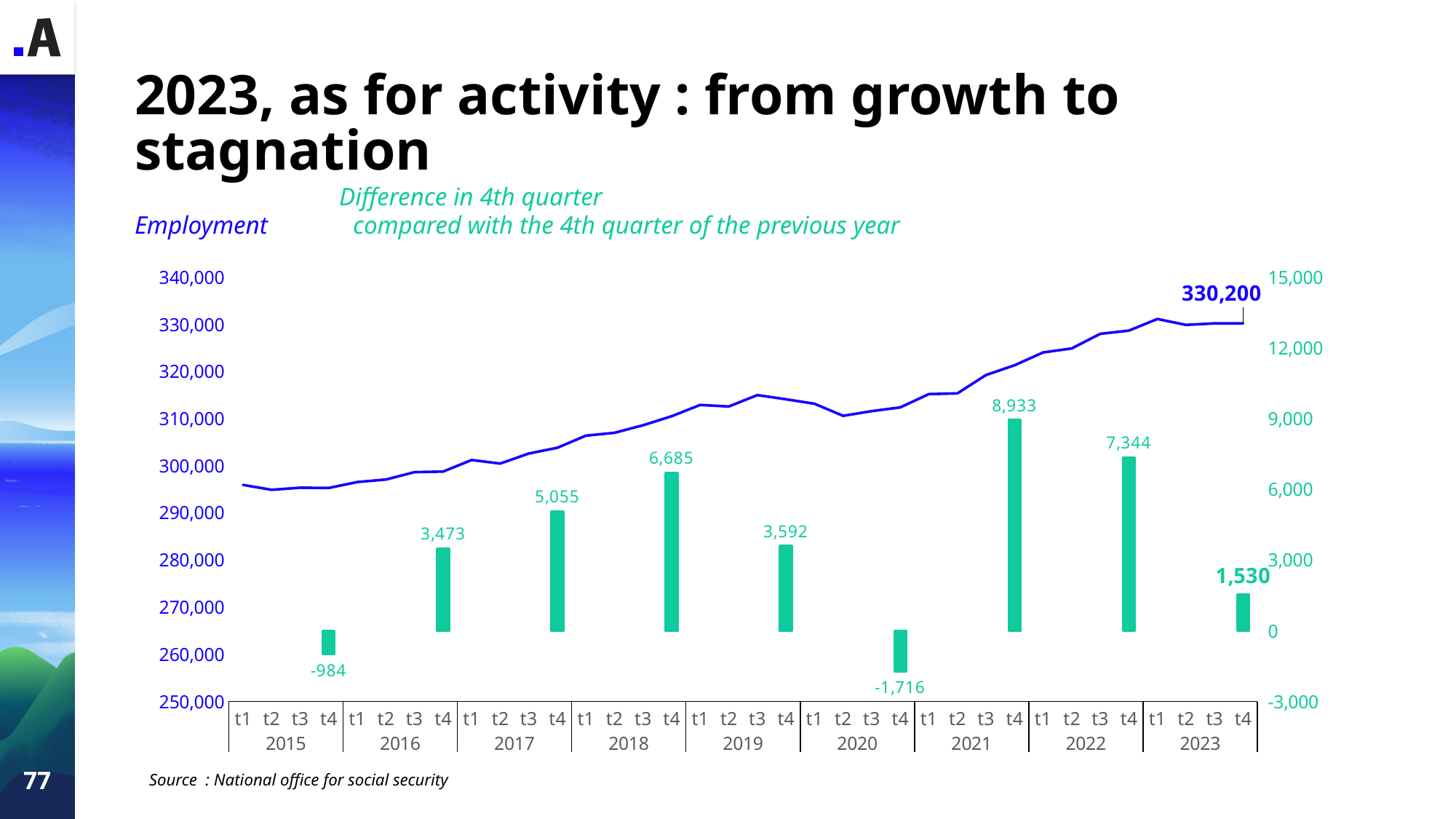
What employment value is labelled at the end of the line in t4 2023? 330,200 Is the employment value in t1 2015 greater or less than 300,000? less What is the difference between the 4th-quarter difference bars for 2022 and 2023? 5,814 What is the difference in the 4th quarter of 2023 compared with the 4th quarter of the previous year? 1,530 How many years are shown on the x axis? 9 Which is larger, the 4th-quarter difference for 2017 or for 2019? 2017 What is the difference in the 4th quarter of 2021 compared with the 4th quarter of the previous year? 8,933 Which year has the highest 4th-quarter difference bar? 2021 What is the source cited below the chart? National office for social security Which year has the lowest 4th-quarter difference bar? 2020 Does the employment line generally rise or fall from 2015 to 2023? rise How many 4th-quarter difference bars have a negative value? 2